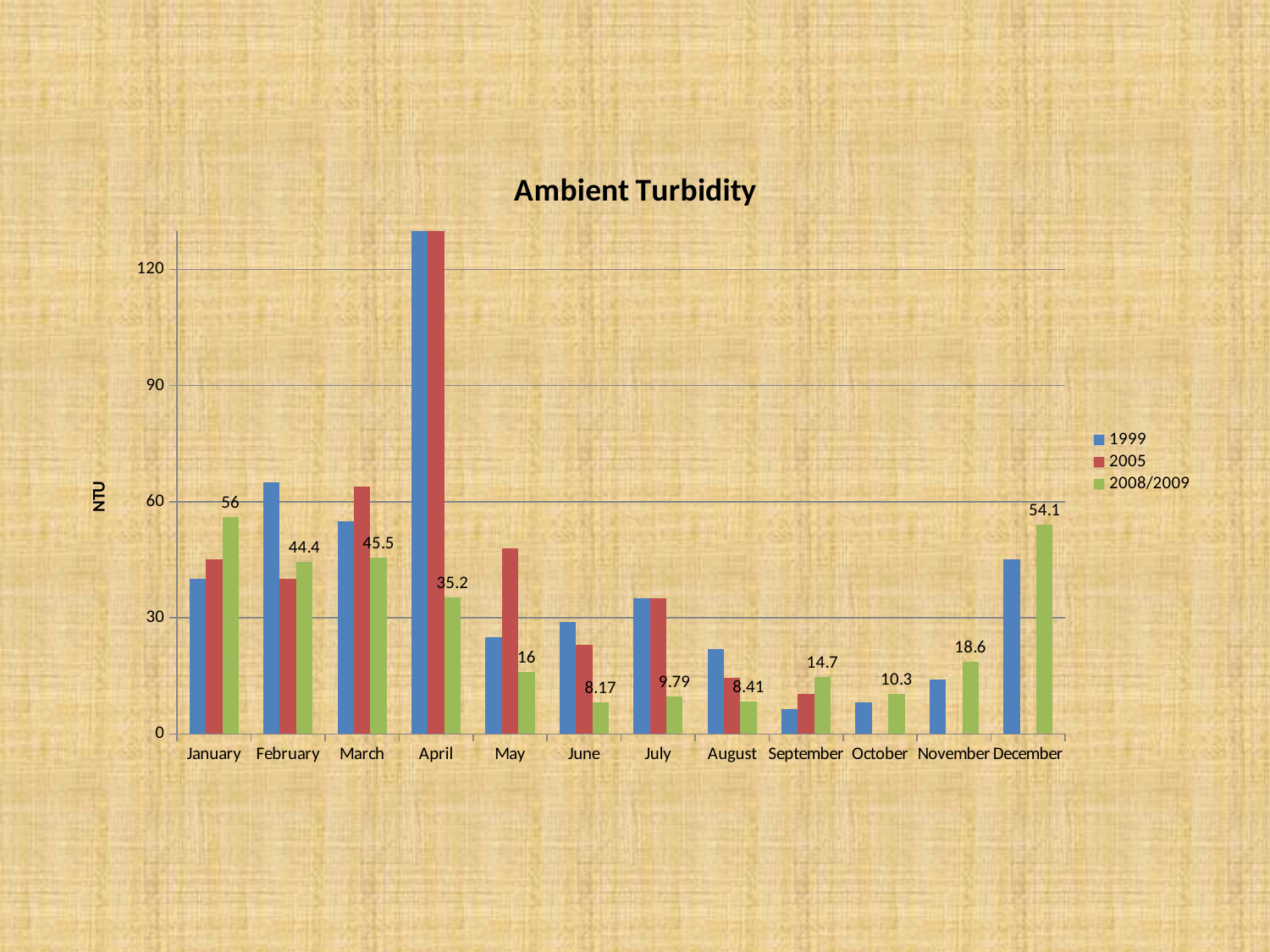
What is the difference between the 2008/2009 values for January and December? 1.9 What is the label on the vertical axis? NTU What is the 2008/2009 value for December? 54.1 How many series does the legend list? 3 Which month has the lowest 2008/2009 value? June Which is larger, the 2008/2009 value for March or for February? March What is the 2008/2009 value for January? 56 What is the 2008/2009 value for September? 14.7 How many months are shown on the x axis? 12 Which month has the highest 2008/2009 value? January Is the 1999 value for February greater or less than 60? greater Is the 2005 value for May greater or less than 30? greater